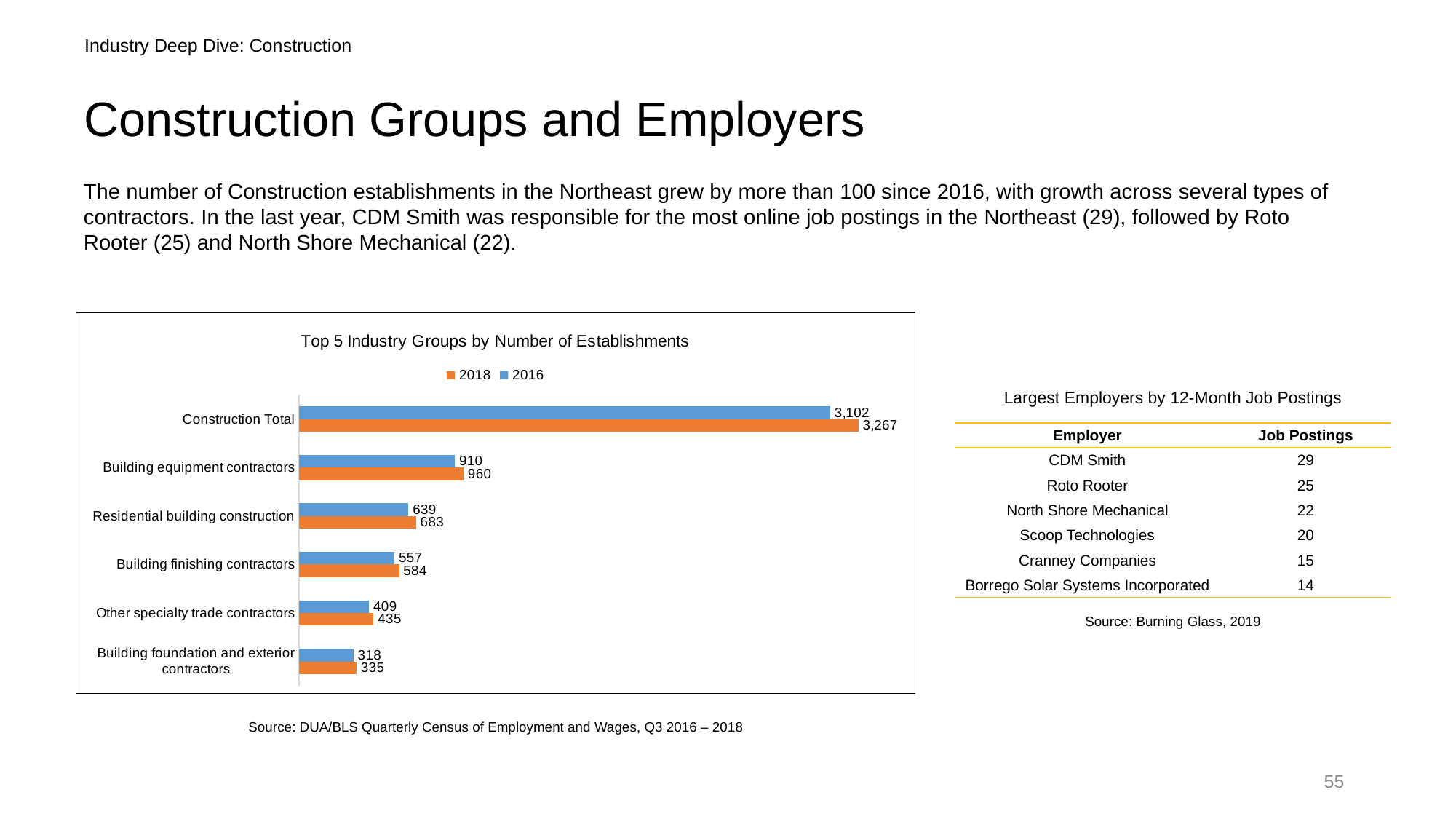
By how much did the Construction Total grow from 2016 to 2018? 165 What was the number of establishments for Residential building construction in 2016? 639 Which is larger: Building finishing contractors in 2018 or Residential building construction in 2016? Residential building construction in 2016 What is the difference between the 2018 and 2016 values for Other specialty trade contractors? 26 Excluding the Construction Total, which industry group had the most establishments in 2018? Building equipment contractors What is the title of the chart? Top 5 Industry Groups by Number of Establishments Which industry group had the fewest establishments in 2016? Building foundation and exterior contractors How many categories are shown on the chart? 6 What kind of chart is shown? Bar chart What was the Construction Total in 2018? 3,267 What was the number of establishments for Building equipment contractors in 2018? 960 How many series does the legend list? 2